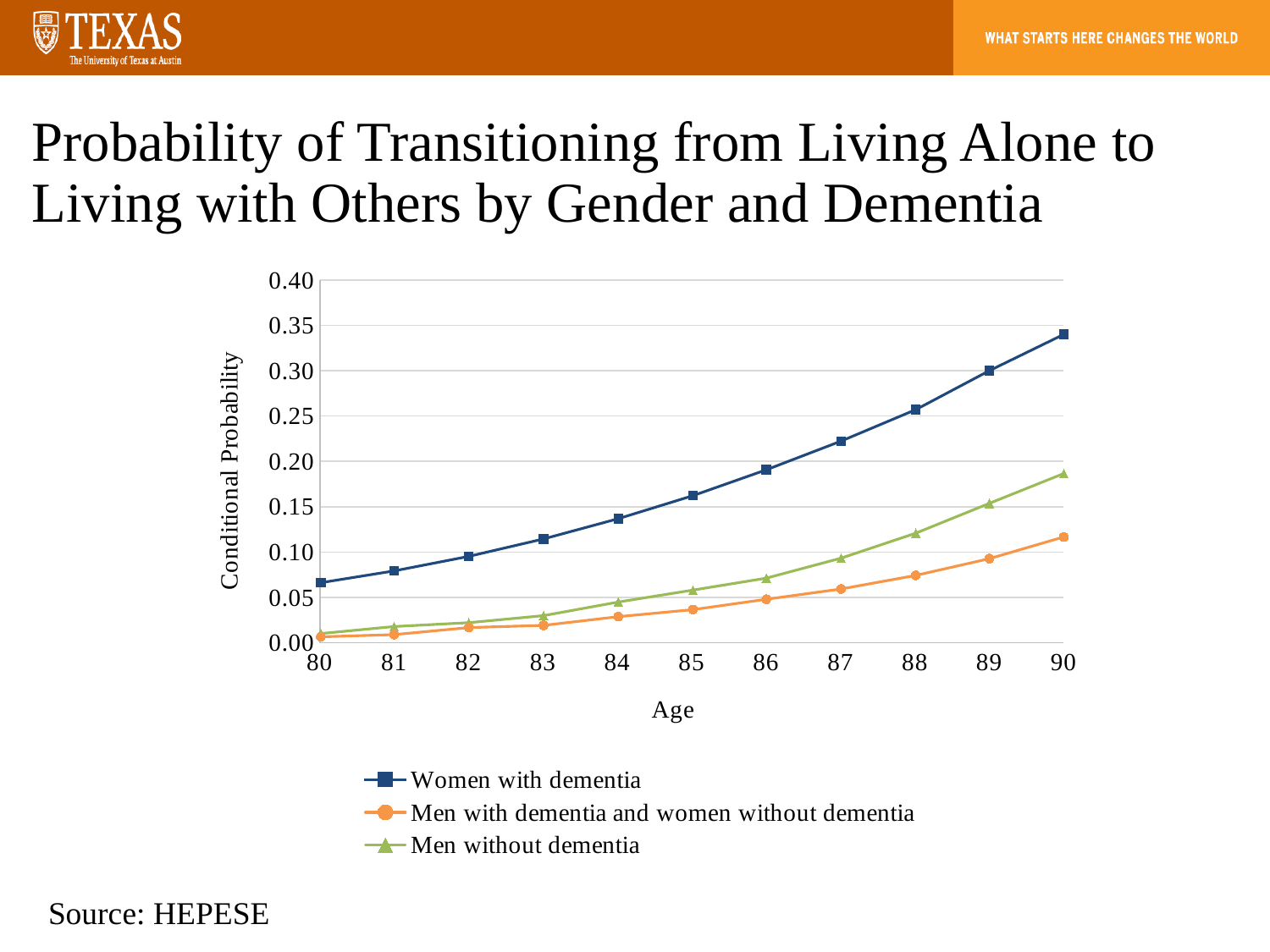
Which series has the highest conditional probability at age 90? Women with dementia Is the value for Men without dementia at age 90 greater or less than 0.20? less Is the value for Women with dementia at age 90 greater or less than 0.30? greater Is the value for Women with dementia at age 80 greater or less than 0.05? greater Do the values for Women with dementia rise or fall as age increases from 80 to 90? rise How many age points are plotted along the x axis? 11 Which series has the lowest conditional probability at age 90? Men with dementia and women without dementia What is the label on the y axis? Conditional Probability What kind of chart is shown on the slide? line chart At age 88, which is larger: the value for Women with dementia or the value for Men without dementia? Women with dementia How many series does the legend list? 3